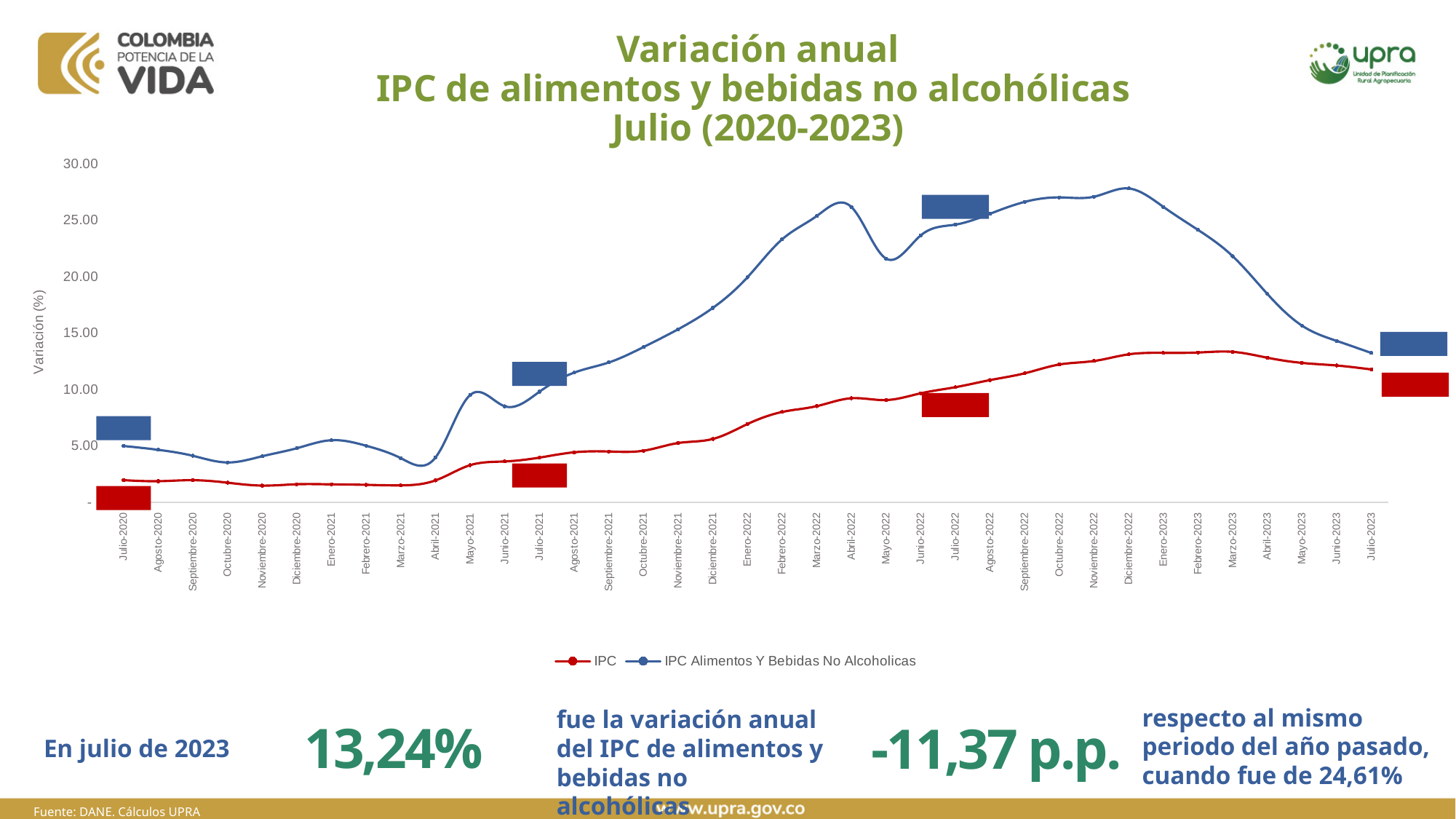
Does the IPC Alimentos Y Bebidas No Alcoholicas series rise or fall from Diciembre-2022 to Julio-2023? fall What kind of chart is shown on the slide? line chart What label is shown on the vertical axis of the chart? Variación (%) How many months are plotted along the x axis? 37 According to the slide, what was the annual variation of the IPC de alimentos y bebidas no alcohólicas in July 2023? 13,24% How many series does the legend list? 2 Is the value of IPC in Marzo-2023 greater or less than 10.00? greater In which month does the IPC Alimentos Y Bebidas No Alcoholicas series reach its highest value? Diciembre-2022 Is the value of IPC in Julio-2020 greater or less than 5.00? less Which series has the larger value in Diciembre-2022, IPC or IPC Alimentos Y Bebidas No Alcoholicas? IPC Alimentos Y Bebidas No Alcoholicas Which series reaches the highest value on the chart? IPC Alimentos Y Bebidas No Alcoholicas Is the value of IPC Alimentos Y Bebidas No Alcoholicas in Diciembre-2022 greater or less than 25.00? greater